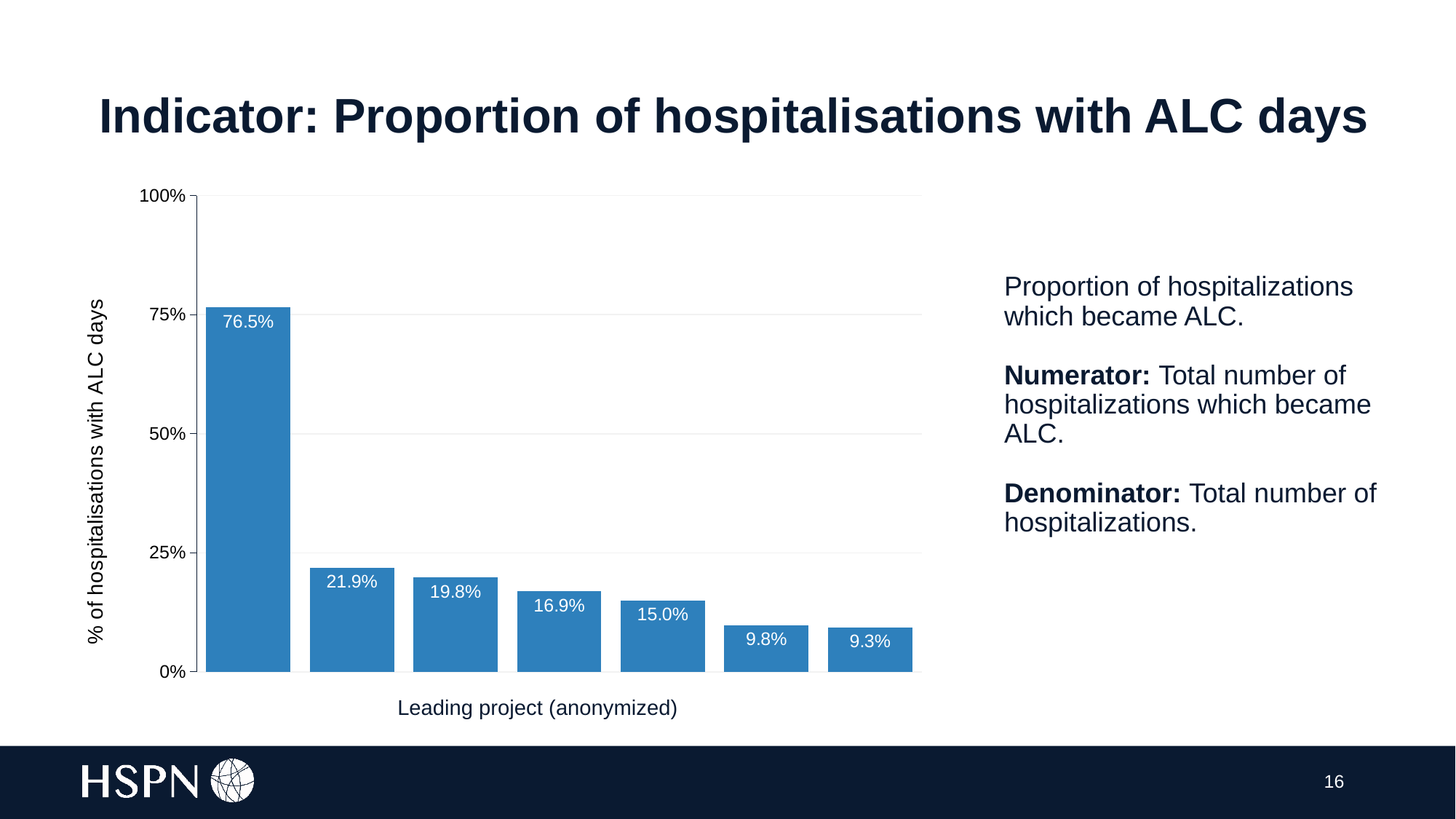
What is the value of the last (rightmost) bar? 9.3% What type of chart is shown on the slide? Bar chart What is the difference between the first bar (76.5%) and the second bar (21.9%)? 54.6% Is the value of the first bar greater or less than 75%? greater What is the value of the first (leftmost) bar in the chart? 76.5% What is the value of the second bar from the left? 21.9% How many bars (projects) are shown in the chart? 7 Which is larger, the third bar (19.8%) or the fourth bar (16.9%)? The third bar (19.8%) What is the value of the fifth bar from the left? 15.0% Do the bar values rise or fall from left to right along the x axis? Fall What is the highest value shown in the chart? 76.5% What is the lowest value shown in the chart? 9.3%